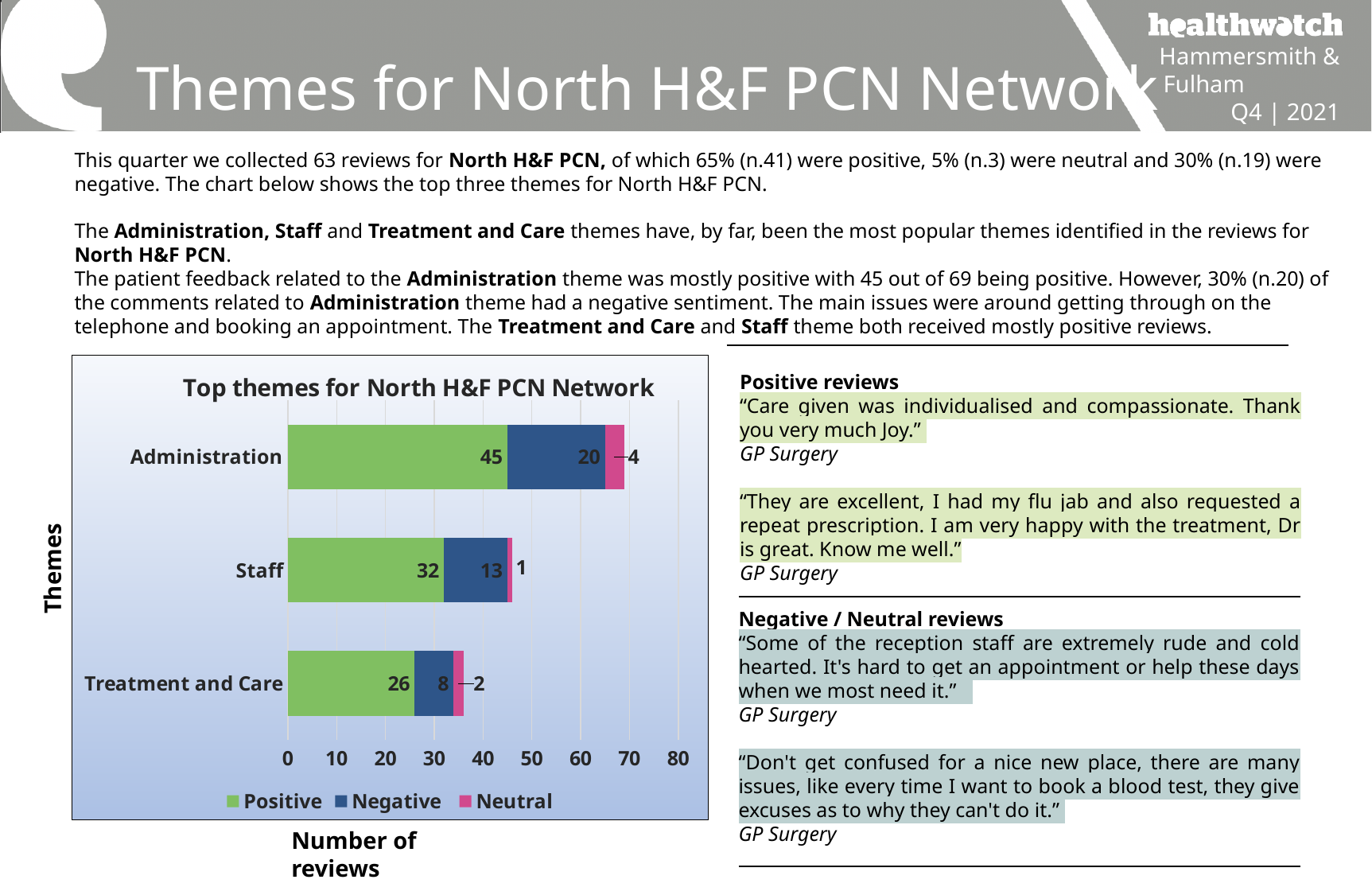
What is the Neutral value for Treatment and Care? 2 What is the total of the stacked bar for Administration? 69 What kind of chart is shown? Stacked bar chart Which theme has the lowest Negative value? Treatment and Care Which is larger, the Negative value for Administration or the Negative value for Staff? Administration Which theme has the highest Positive value? Administration How many themes are shown on the chart? 3 How many series does the legend list? 3 What is the total of the stacked bar for Treatment and Care? 36 What is the Positive value for Administration? 45 What is the Negative value for Staff? 13 What is the difference between the Positive values for Administration and Staff? 13